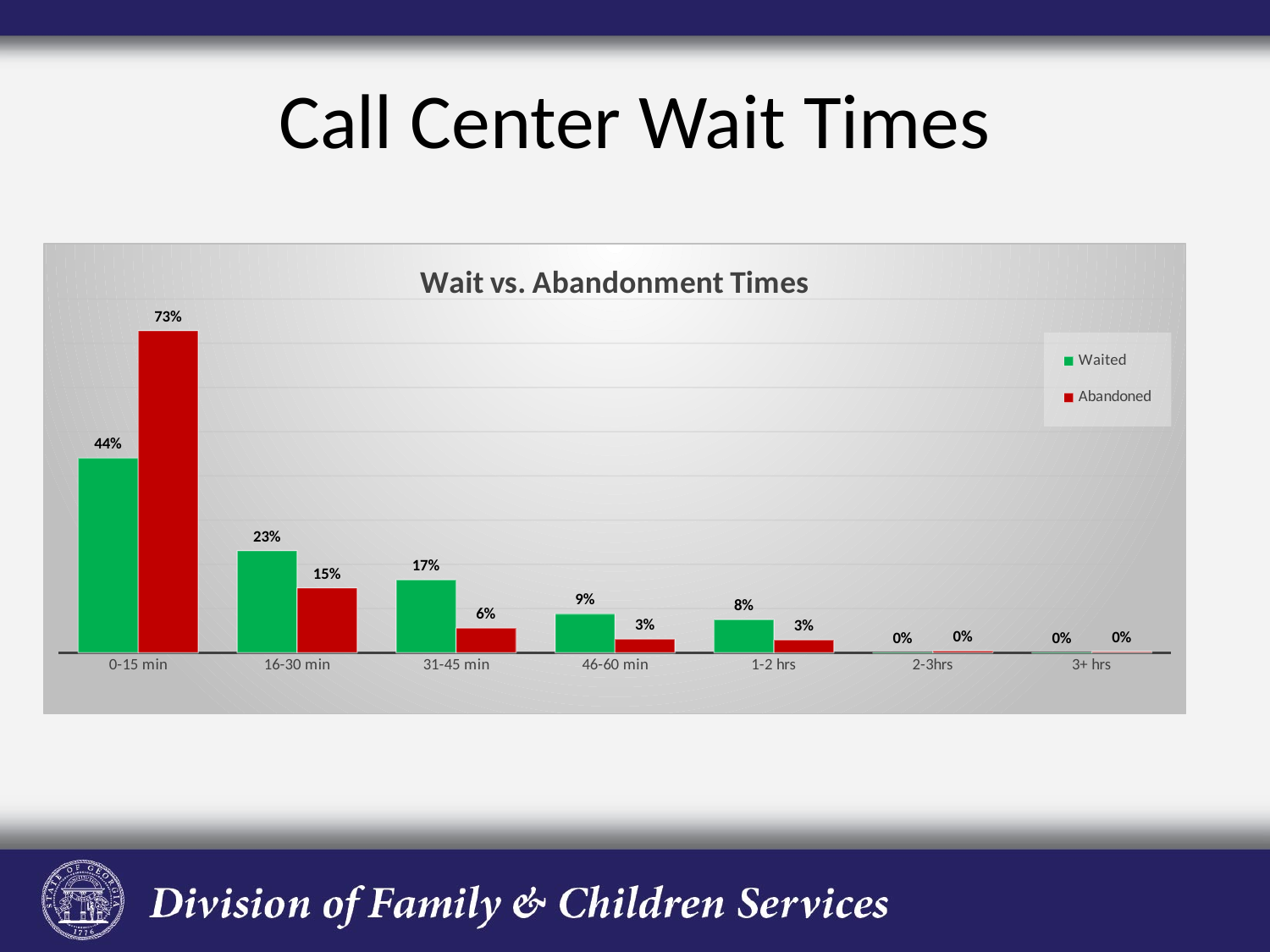
How many series does the legend list? 2 What is the Abandoned value for the 16-30 min category? 15% Which is larger for the 1-2 hrs category, the Waited value or the Abandoned value? Waited Which category has the highest Abandoned value? 0-15 min What is the Waited value for the 31-45 min category? 17% Which category has the highest Waited value? 0-15 min What is the difference between the Waited values for 16-30 min and 46-60 min? 14% How many wait-time categories are shown on the x axis? 7 What is the Waited value for the 0-15 min category? 44% What is the difference between the Abandoned and Waited values for the 0-15 min category? 29% What is the Abandoned value for the 0-15 min category? 73% What type of chart is shown on the slide? Bar chart